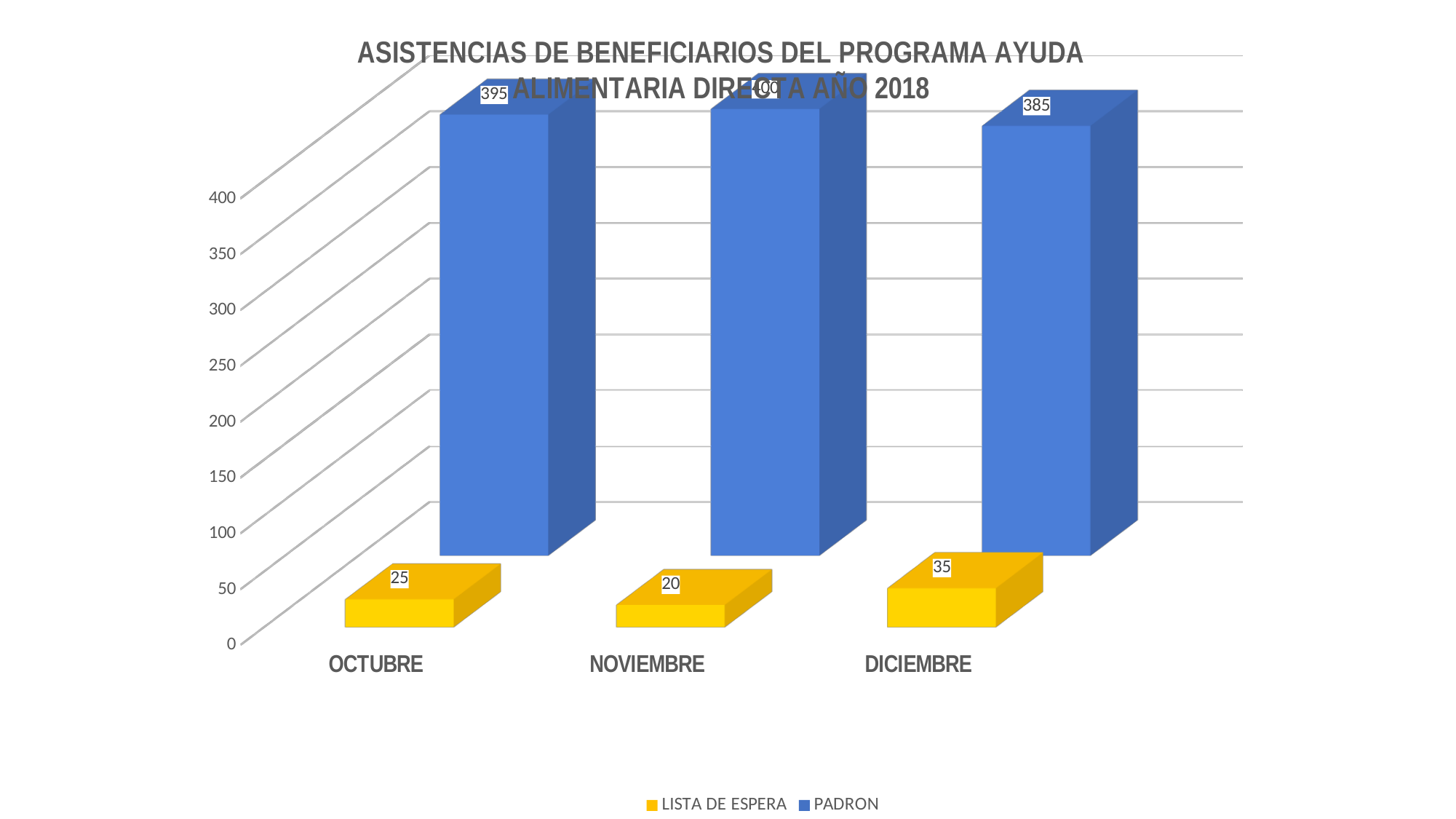
Which month has the lowest LISTA DE ESPERA value? NOVIEMBRE What is the difference between the PADRON values for OCTUBRE and DICIEMBRE? 10 How many series does the legend list? 2 What kind of chart is shown on the slide? Bar chart What is the LISTA DE ESPERA value for OCTUBRE? 25 Which is larger, the LISTA DE ESPERA value for DICIEMBRE or for OCTUBRE? DICIEMBRE How many months are shown on the x axis? 3 What is the PADRON value for OCTUBRE? 395 Which month has the highest LISTA DE ESPERA value? DICIEMBRE What is the PADRON value for DICIEMBRE? 385 What is the LISTA DE ESPERA value for DICIEMBRE? 35 What is the LISTA DE ESPERA value for NOVIEMBRE? 20